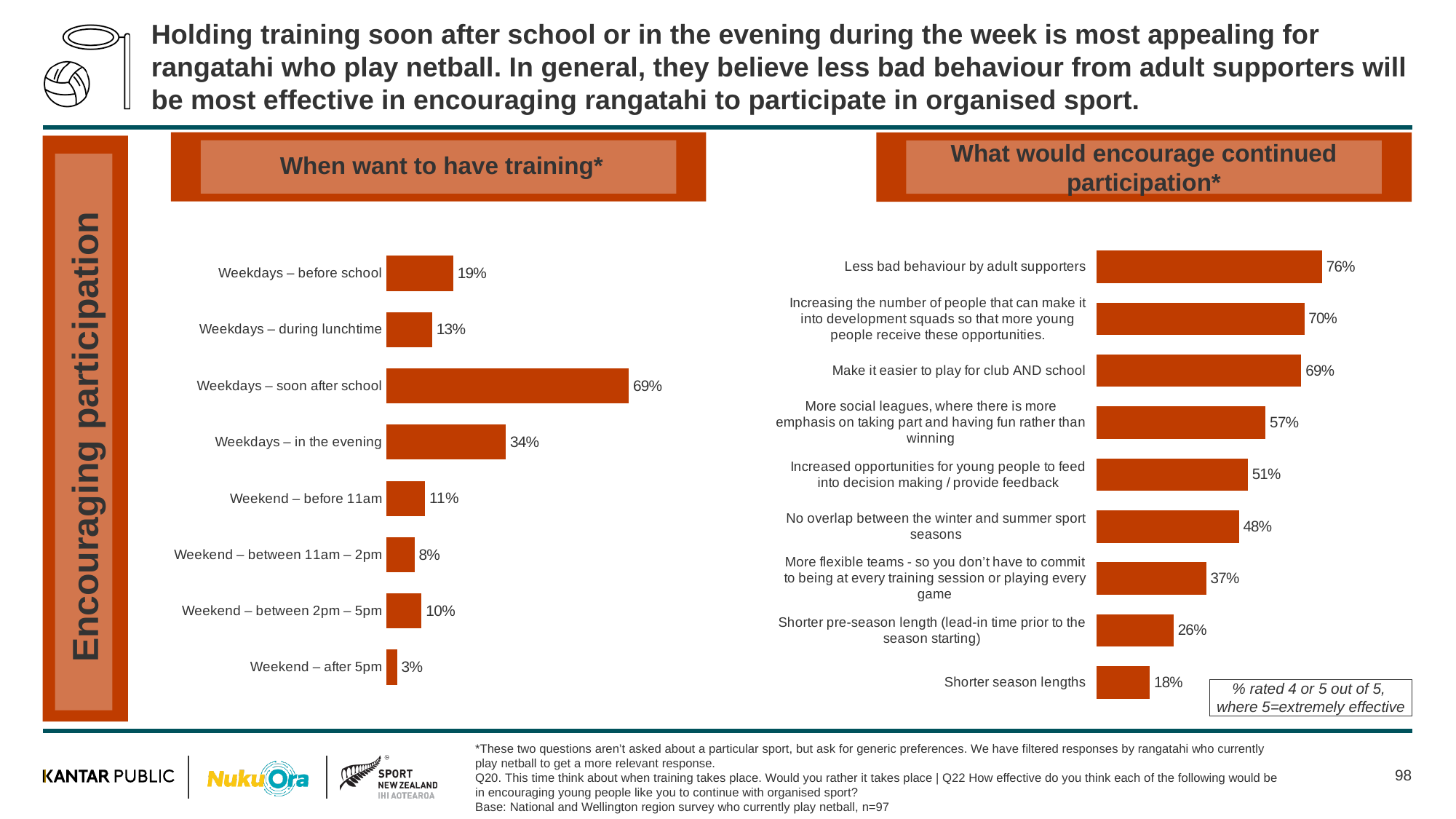
In the 'What would encourage continued participation*' chart, what is the value for 'More social leagues, where there is more emphasis on taking part and having fun rather than winning'? 57% In the 'When want to have training*' chart, how many categories are shown? 8 In the 'When want to have training*' chart, what is the value for 'Weekdays – soon after school'? 69% In the 'When want to have training*' chart, what is the difference between 'Weekdays – in the evening' and 'Weekdays – before school'? 15% In the 'What would encourage continued participation*' chart, how many categories are shown? 9 What type of chart is the 'When want to have training*' chart? Bar chart In the 'When want to have training*' chart, which is larger: 'Weekend – before 11am' or 'Weekend – between 2pm – 5pm'? Weekend – before 11am In the 'What would encourage continued participation*' chart, what is the value for 'Shorter season lengths'? 18% In the 'What would encourage continued participation*' chart, which category has the highest value? Less bad behaviour by adult supporters In the 'When want to have training*' chart, which category has the lowest value? Weekend – after 5pm In the 'What would encourage continued participation*' chart, what is the value for 'Less bad behaviour by adult supporters'? 76% In the 'What would encourage continued participation*' chart, what is the difference between 'Make it easier to play for club AND school' and 'No overlap between the winter and summer sport seasons'? 21%